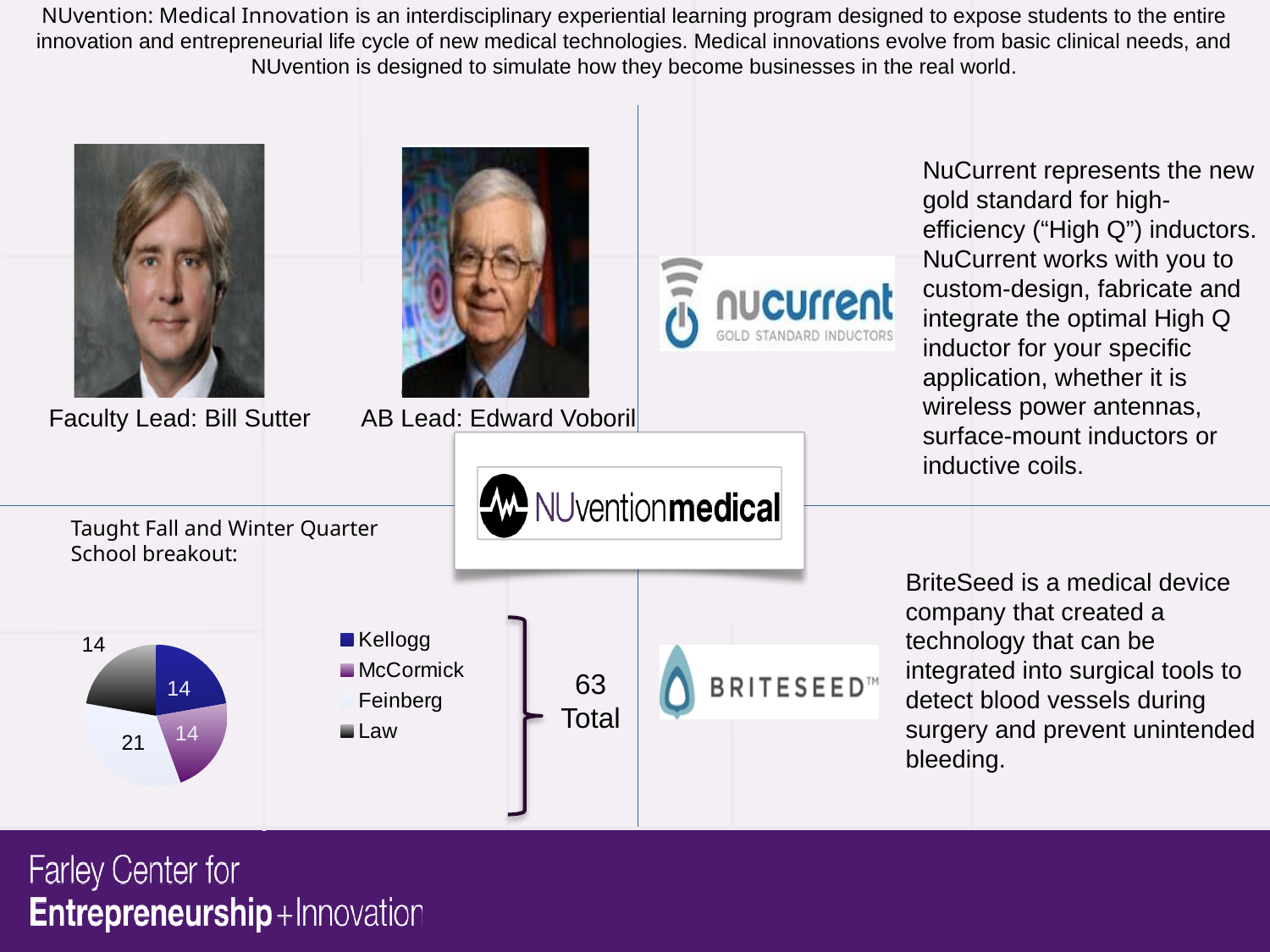
What share of the pie does Feinberg represent? 33.3% Which is larger in the pie chart, Feinberg or Law? Feinberg What is the value for Kellogg in the pie chart? 14 How many entries does the pie chart's legend list? 4 What kind of chart is shown on the slide? pie chart What colour represents Kellogg in the pie chart legend? blue Which school has the largest slice in the pie chart? Feinberg What is the value for Feinberg in the pie chart? 21 What is the value for Law in the pie chart? 14 How many slices does the pie chart have? 4 What is the difference between the Feinberg value and the McCormick value? 7 What is the total of all slices in the pie chart, as stated on the slide? 63